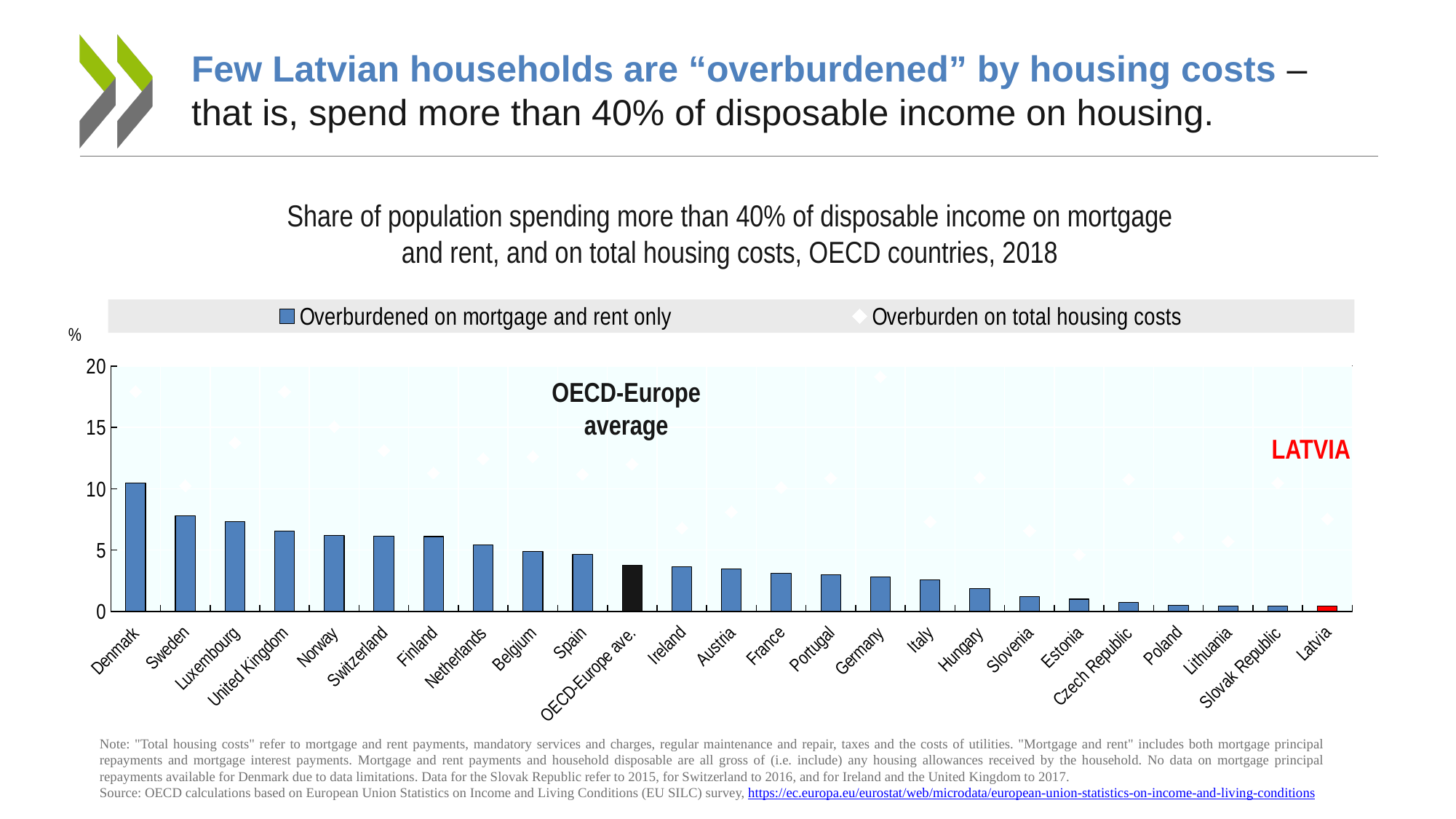
Which country's bar is highlighted in red on the chart? Latvia What year does the chart title say the data refer to? 2018 Which country has the highest bar for 'Overburdened on mortgage and rent only'? Denmark What type of chart is shown on the slide? bar chart Which has a larger 'Overburdened on mortgage and rent only' bar, Denmark or Sweden? Denmark Do the 'Overburdened on mortgage and rent only' bars rise or fall from left to right along the x axis? fall Is the 'Overburdened on mortgage and rent only' value for Denmark greater or less than 10? greater Is the 'Overburdened on mortgage and rent only' value for Luxembourg greater or less than 5? greater How many categories are shown along the x axis? 25 How many series does the legend list? 2 Is the 'Overburdened on mortgage and rent only' value for Sweden greater or less than 10? less